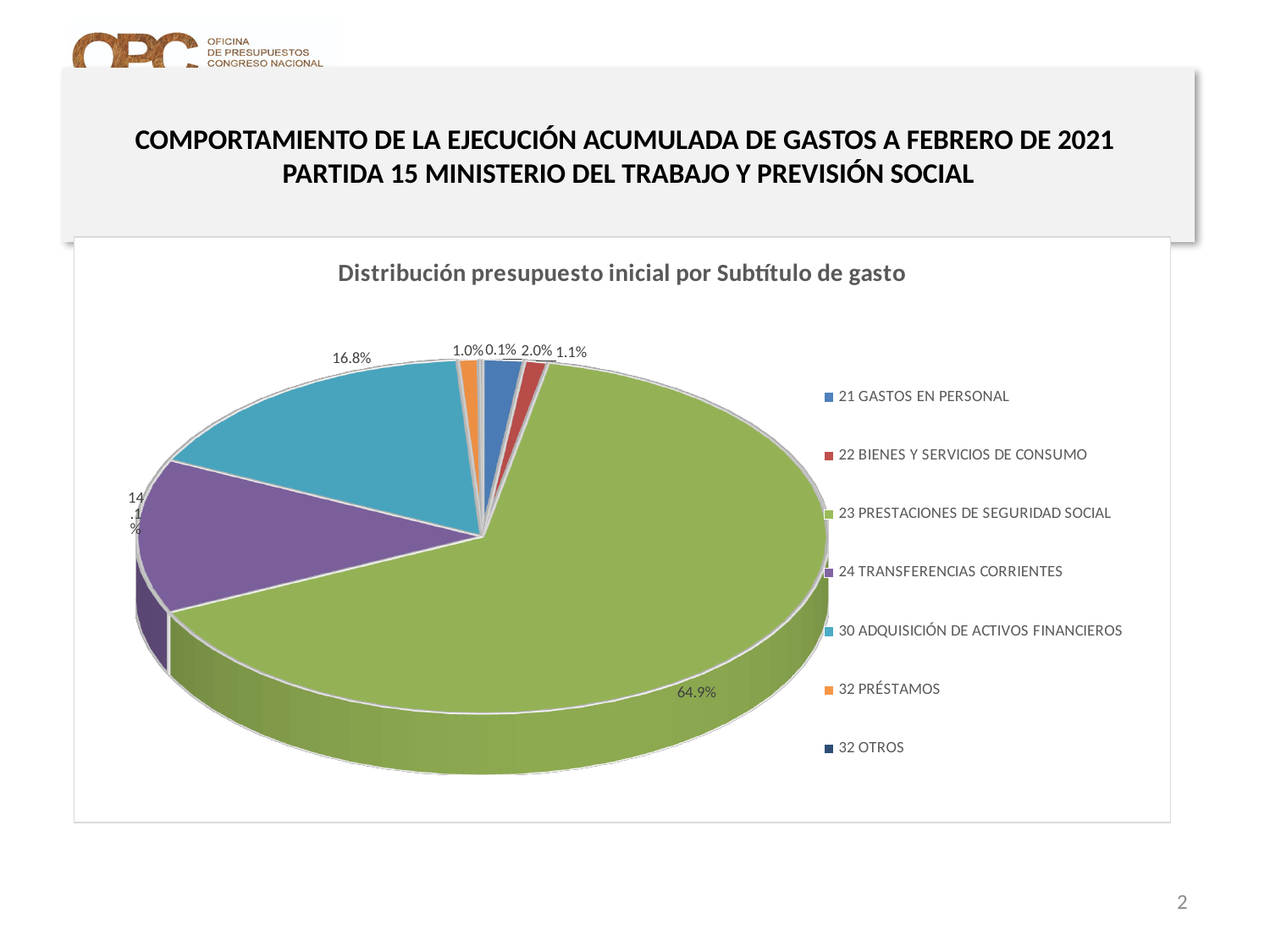
How many entries does the chart legend list? 7 What share of the pie does 32 OTROS represent? 0.1% What kind of chart is shown on the slide? pie chart What is the title of the chart? Distribución presupuesto inicial por Subtítulo de gasto What share of the pie does 24 TRANSFERENCIAS CORRIENTES represent? 14.1% Which is larger, the share for 30 ADQUISICIÓN DE ACTIVOS FINANCIEROS or the share for 24 TRANSFERENCIAS CORRIENTES? 30 ADQUISICIÓN DE ACTIVOS FINANCIEROS What share of the pie does 23 PRESTACIONES DE SEGURIDAD SOCIAL represent? 64.9% Which category has the largest slice of the pie? 23 PRESTACIONES DE SEGURIDAD SOCIAL What is the difference in percentage points between the share for 30 ADQUISICIÓN DE ACTIVOS FINANCIEROS and the share for 24 TRANSFERENCIAS CORRIENTES? 2.7 Which category has the smallest slice of the pie? 32 OTROS